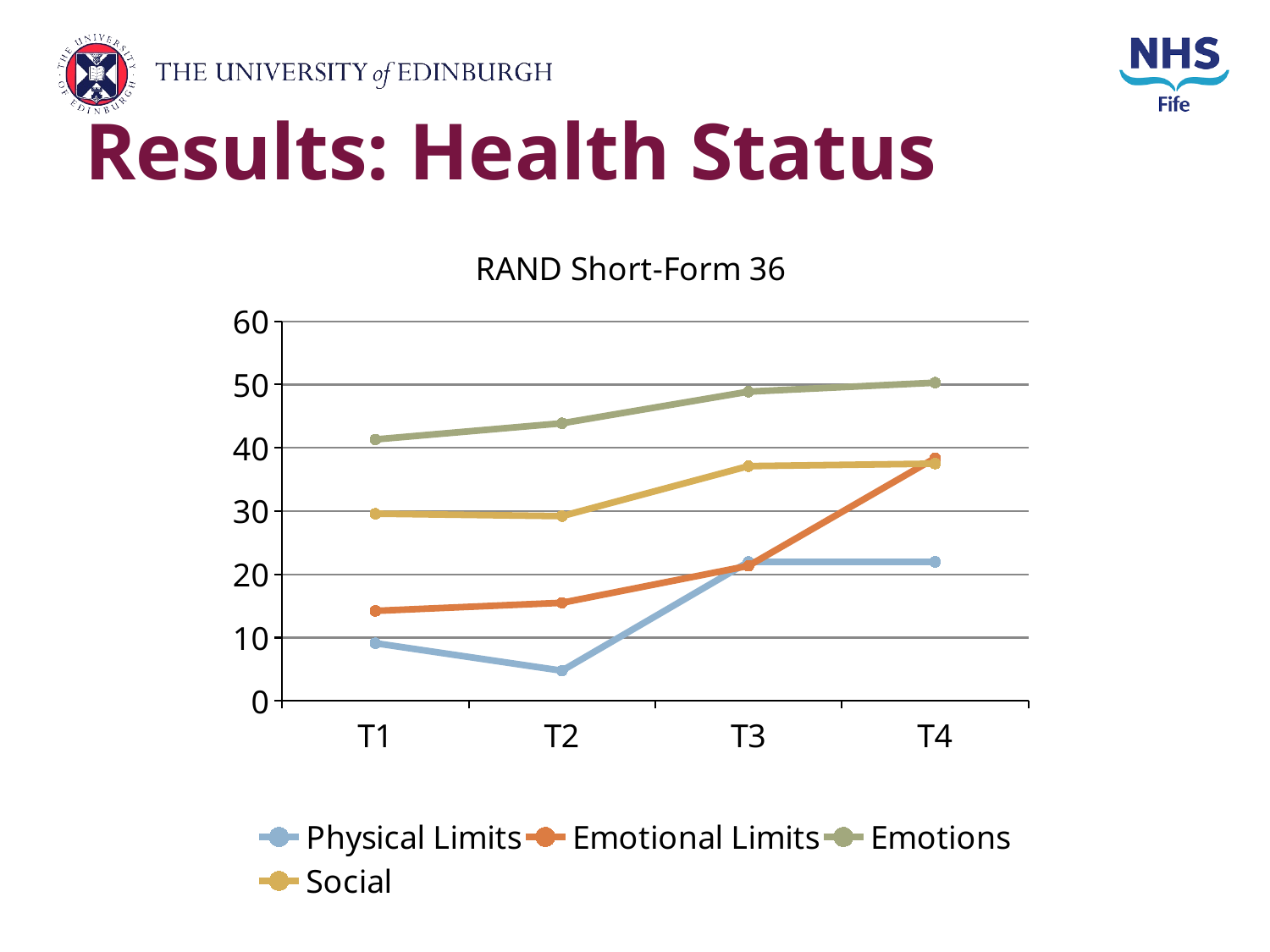
How many time points are shown on the x axis? 4 What is the title of the chart? RAND Short-Form 36 Which series is drawn in orange? Emotional Limits Is the value for Physical Limits at T2 greater or less than 10? less Which series has the lowest value at T2? Physical Limits At T1, which is larger: Social or Emotional Limits? Social Do the values for Emotions rise or fall from T1 to T4? rise What kind of chart is shown on the slide? line chart Which series has the highest value at T1? Emotions Is the value for Emotional Limits at T1 greater or less than 20? less Is the value for Emotions at T4 greater or less than 40? greater How many series does the legend list? 4